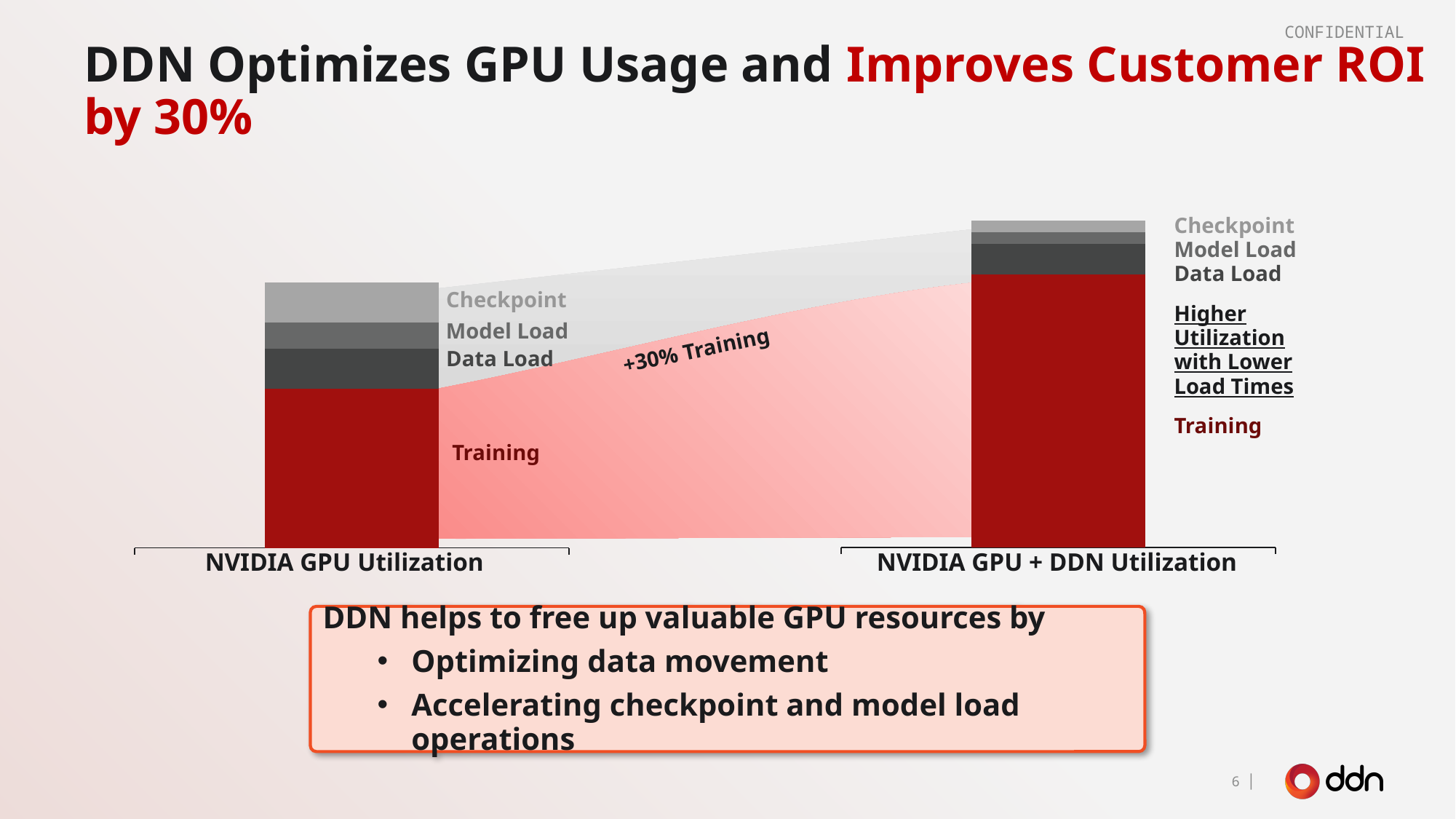
Which segment is shown in red in the chart? Training Which bar has the smaller Checkpoint segment, NVIDIA GPU Utilization or NVIDIA GPU + DDN Utilization? NVIDIA GPU + DDN Utilization Which bar is taller overall, NVIDIA GPU Utilization or NVIDIA GPU + DDN Utilization? NVIDIA GPU + DDN Utilization How many bars does the chart show? 2 How many segments make up each stacked bar in the chart? 4 By what percentage does the chart say Training increases with DDN? +30% Which segment is the largest in the NVIDIA GPU Utilization bar? Training What kind of chart is shown on the slide? stacked bar chart Which segment is the largest in the NVIDIA GPU + DDN Utilization bar? Training Which bar has the larger Training segment, NVIDIA GPU Utilization or NVIDIA GPU + DDN Utilization? NVIDIA GPU + DDN Utilization What is the label of the topmost segment in each stacked bar? Checkpoint Does the Training segment rise or fall from the NVIDIA GPU Utilization bar to the NVIDIA GPU + DDN Utilization bar? rise